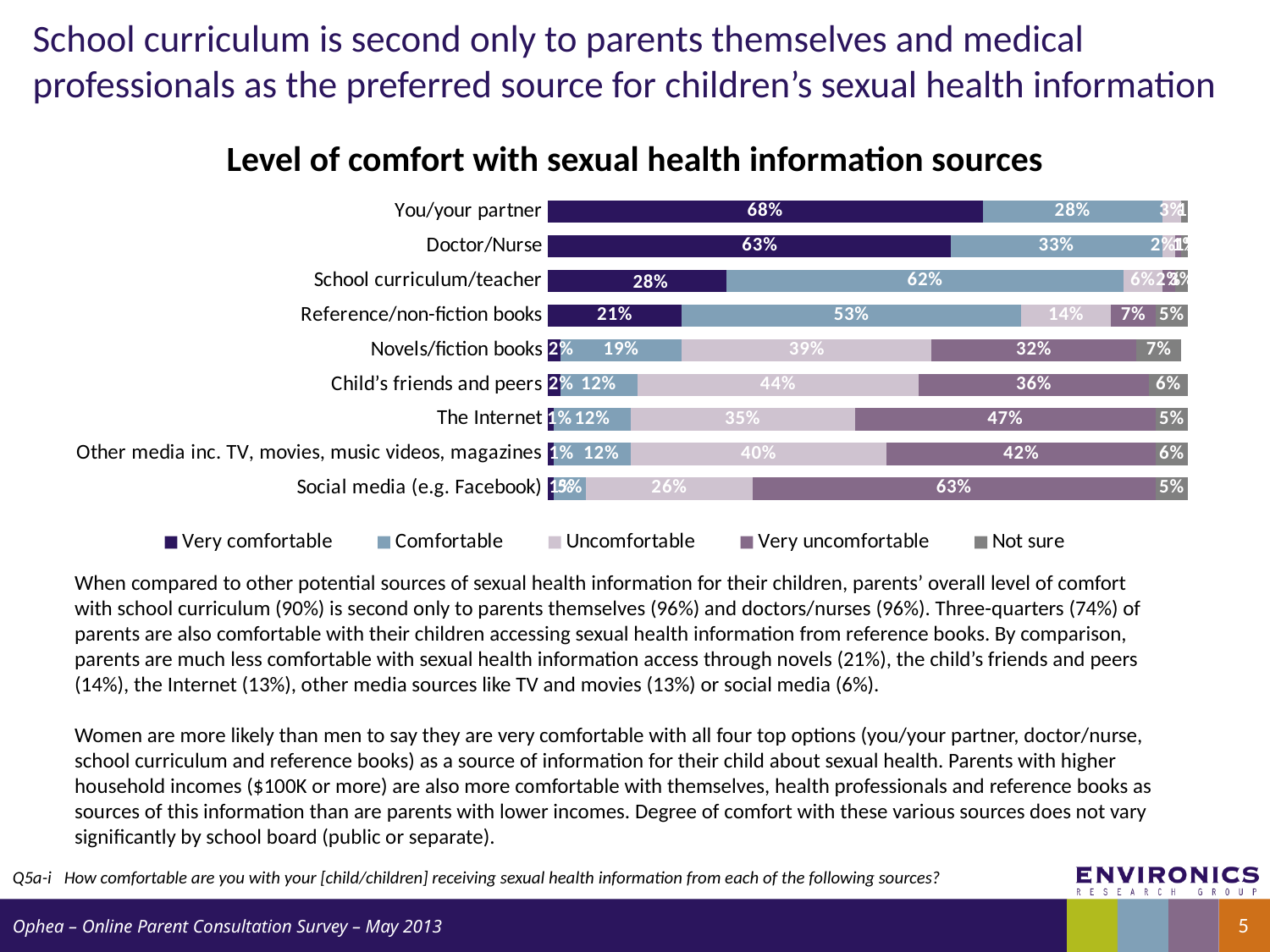
How many information sources (categories) are plotted in the chart? 9 What is the 'Very uncomfortable' value for Social media (e.g. Facebook)? 63% Which is larger: the 'Very uncomfortable' value for The Internet or for Other media inc. TV, movies, music videos, magazines? The Internet Which source has the highest 'Very comfortable' value? You/your partner Which source has the highest 'Very uncomfortable' value? Social media (e.g. Facebook) What is the 'Comfortable' value for School curriculum/teacher? 62% What is the title of the chart? Level of comfort with sexual health information sources What kind of chart is shown on the slide? Stacked bar chart What is the 'Uncomfortable' value for Child's friends and peers? 44% What is the difference between the 'Very comfortable' values for You/your partner and Doctor/Nurse? 5% What is the 'Very comfortable' value for You/your partner? 68% How many series does the legend list? 5